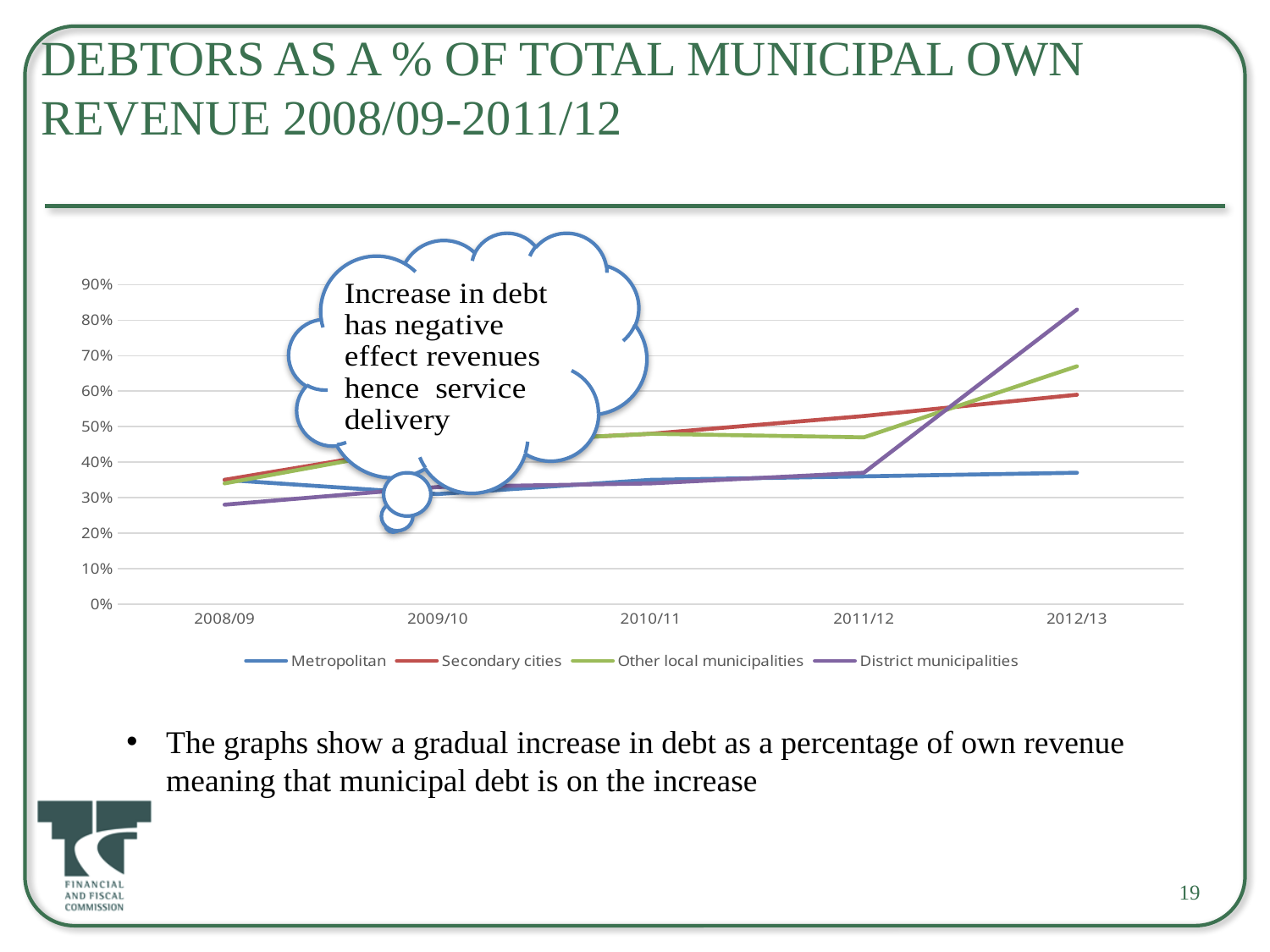
Which series has the lowest value in 2008/09? District municipalities Which series has the lowest value in 2012/13? Metropolitan Which colour is used for the District municipalities line? purple Is the value for Metropolitan in 2012/13 greater or less than 40%? less Which series has the highest value in 2012/13? District municipalities Is the value for District municipalities in 2012/13 greater or less than 80%? greater Is the value for Other local municipalities in 2012/13 greater or less than 60%? greater How many series does the legend list? 4 Do the values for Secondary cities rise or fall from 2008/09 to 2012/13? rise How many financial years are shown along the x axis? 5 What kind of chart is shown on the slide? line chart